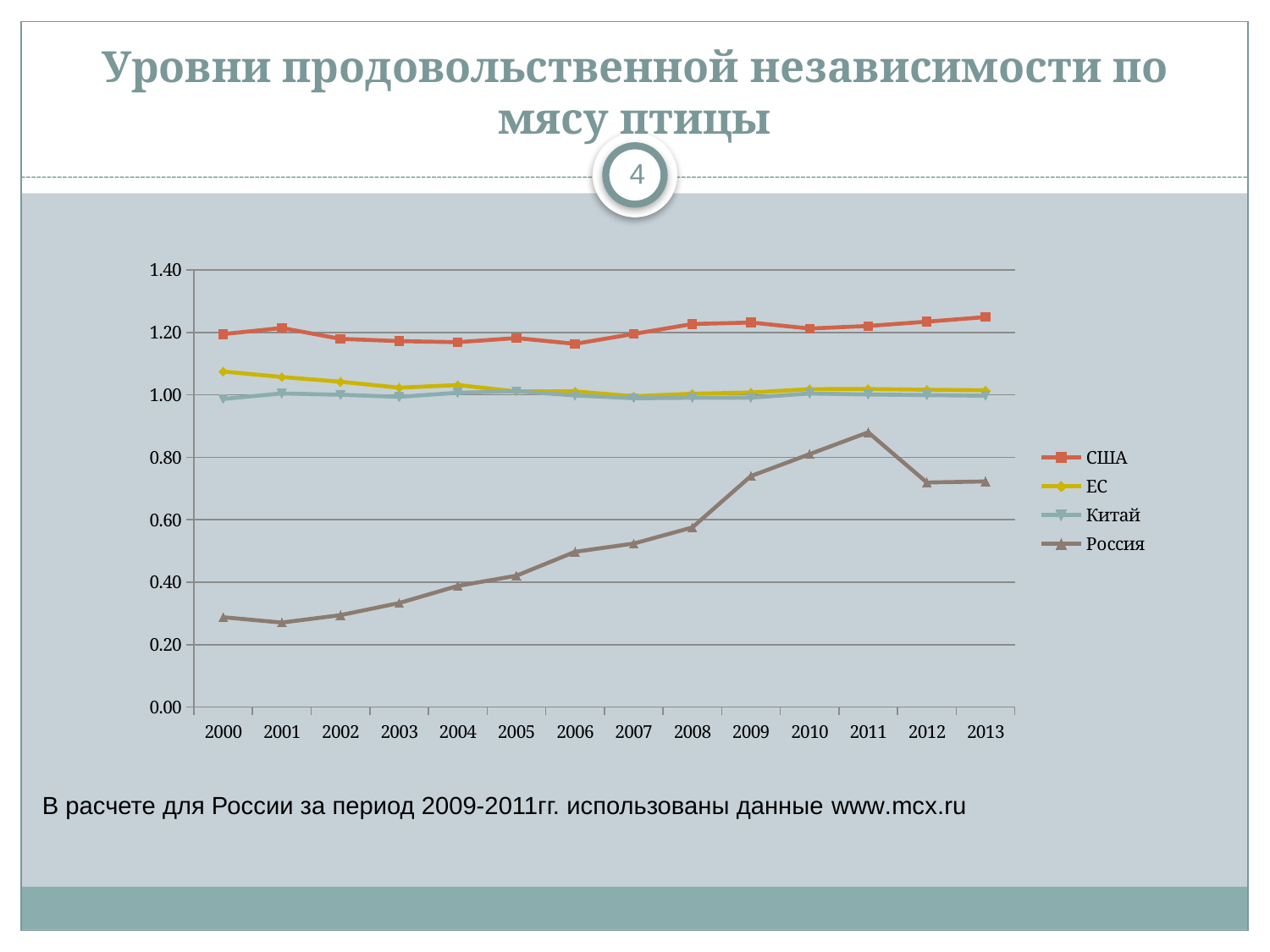
Which series is shown with a red line and square markers? США Which series has the lowest values across all years? Россия Is the value for США in 2013 greater or less than 1.20? greater How many years are shown on the x axis? 14 What kind of chart is shown on the slide? line chart Which is larger in 2005, the value for США or the value for Россия? США Is the value for Россия in 2000 greater or less than 0.40? less Which series has the highest values across all years? США How many series does the legend list? 4 Is the value for Россия in 2011 greater or less than 0.80? greater Does the Россия series generally rise or fall from 2000 to 2011? rise In which year does the Россия series reach its highest value? 2011